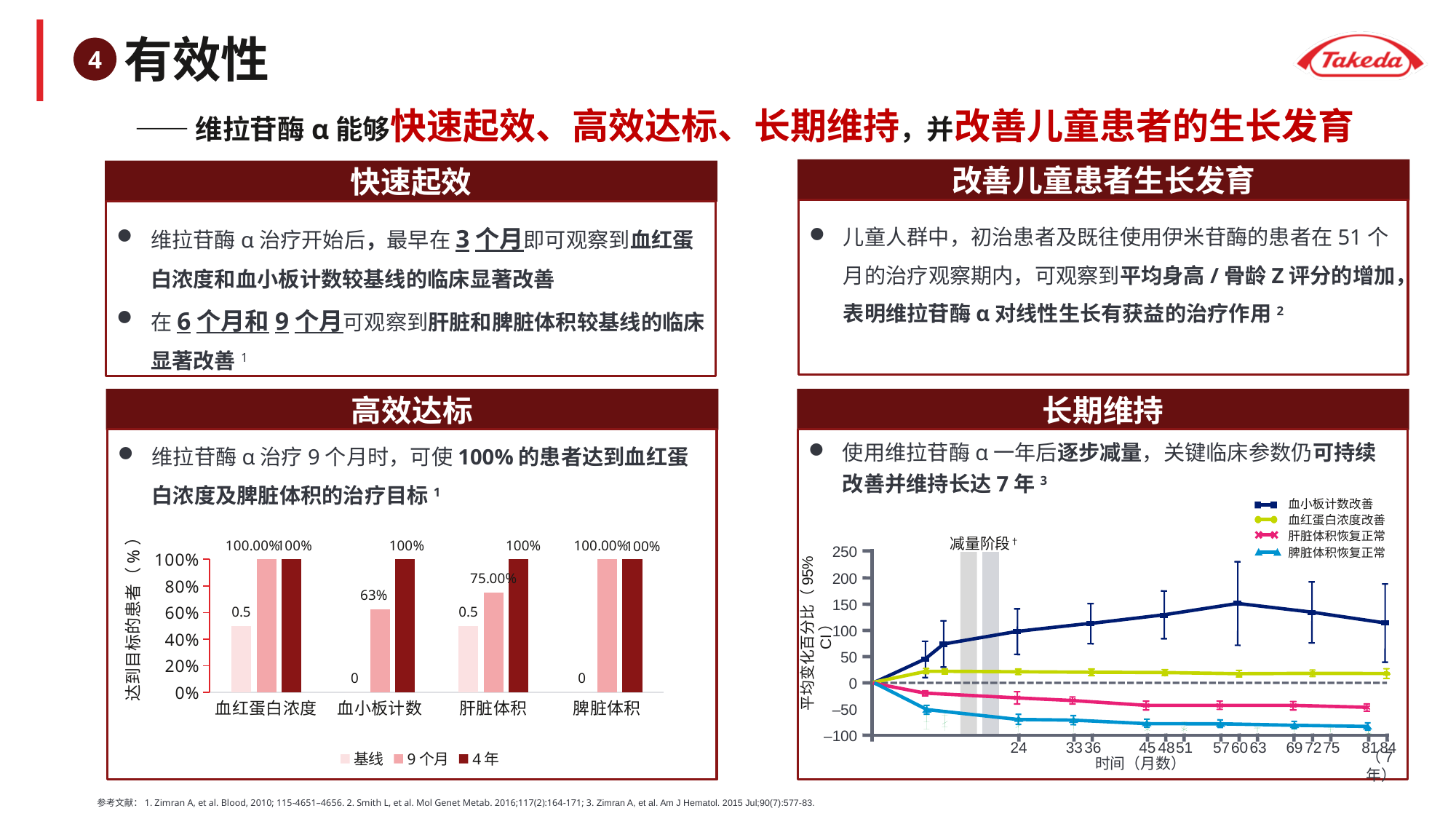
In the bottom-right line chart, is the value for 脾脏体积恢复正常 at 24 months greater or less than –50? less In the bottom-left bar chart, what is the 基线 value for 血红蛋白浓度? 0.5 In the bottom-left bar chart, what is the 9 个月 value for 血小板计数? 63% In the bottom-left bar chart, how many categories are shown on the x axis? 4 What kind of chart is shown in the 高效达标 panel at the bottom left? bar chart In the bottom-left bar chart, how many series does the legend list? 3 In the bottom-right line chart (长期维持), how many series does the legend list? 4 In the bottom-right line chart, does the 脾脏体积恢复正常 line rise or fall from 0 to 24 months? fall In the bottom-left bar chart, which category has the lowest 9 个月 value? 血小板计数 In the bottom-left bar chart, what is the 4 年 value for 脾脏体积? 100% In the bottom-left bar chart, what is the 9 个月 value for 肝脏体积? 75.00% In the bottom-left bar chart, is the 9 个月 value for 肝脏体积 larger or smaller than the 9 个月 value for 血小板计数? larger